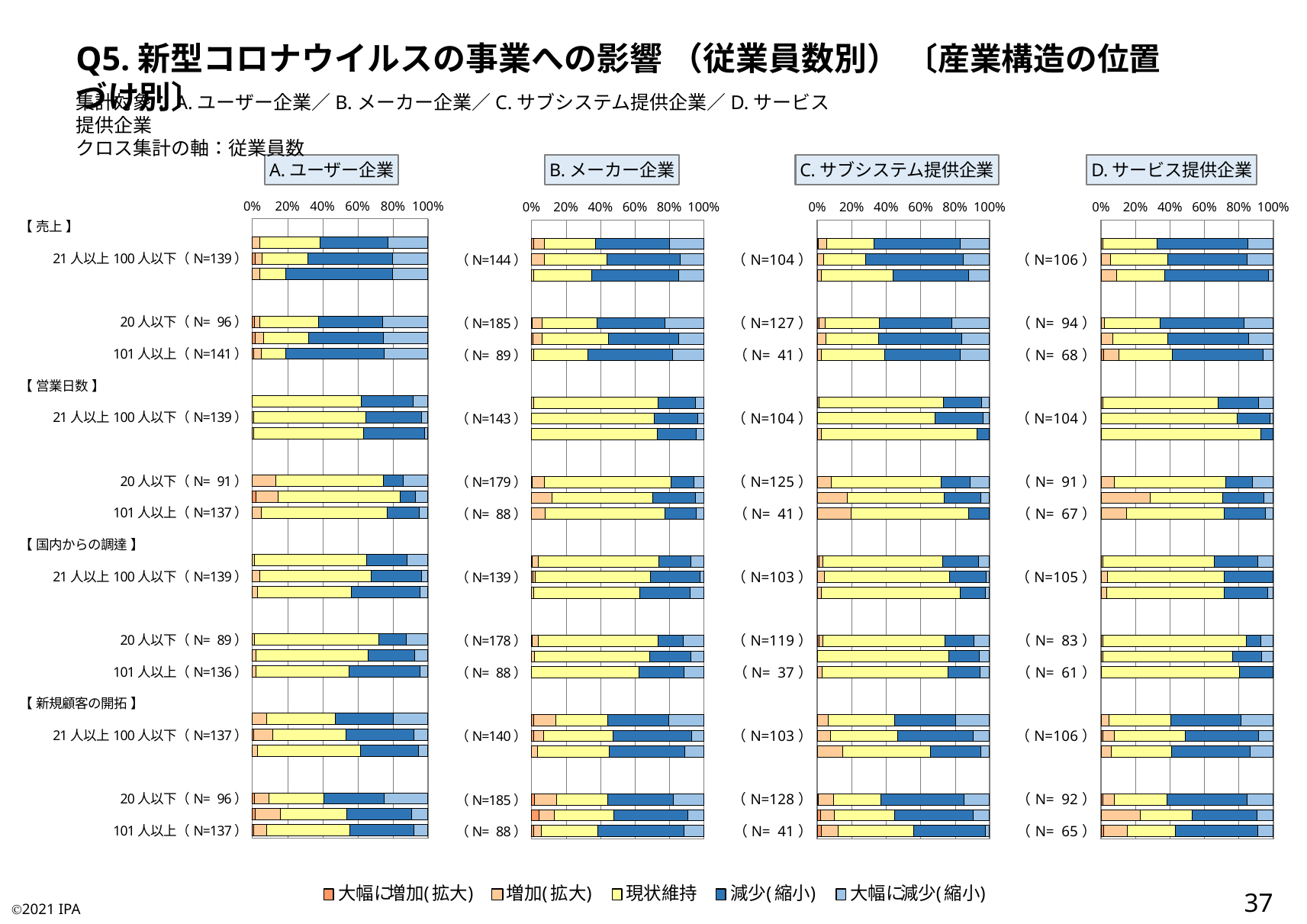
What kind of chart is used for A. ユーザー企業? bar chart In chart D. サービス提供企業, what is N for 新規顧客の開拓, 101人以上? 65 What are the legend entries, from left to right? 大幅に増加(拡大), 増加(拡大), 現状維持, 減少(縮小), 大幅に減少(縮小) In chart B. メーカー企業, what is N for 売上, 20人以下? 185 What is the title of the fourth (rightmost) chart? D. サービス提供企業 How many charts are shown on the slide? 4 In chart A. ユーザー企業, what is N for 売上, 21人以上100人以下? 139 In chart C. サブシステム提供企業, what is N for 売上, 101人以上? 41 In chart A. ユーザー企業, for 営業日数, 101人以上 (N=137), is the 現状維持 share greater or less than 50%? greater For 売上, 20人以下, which chart has the larger N: B. メーカー企業 or D. サービス提供企業? B. メーカー企業 How many series does the legend list? 5